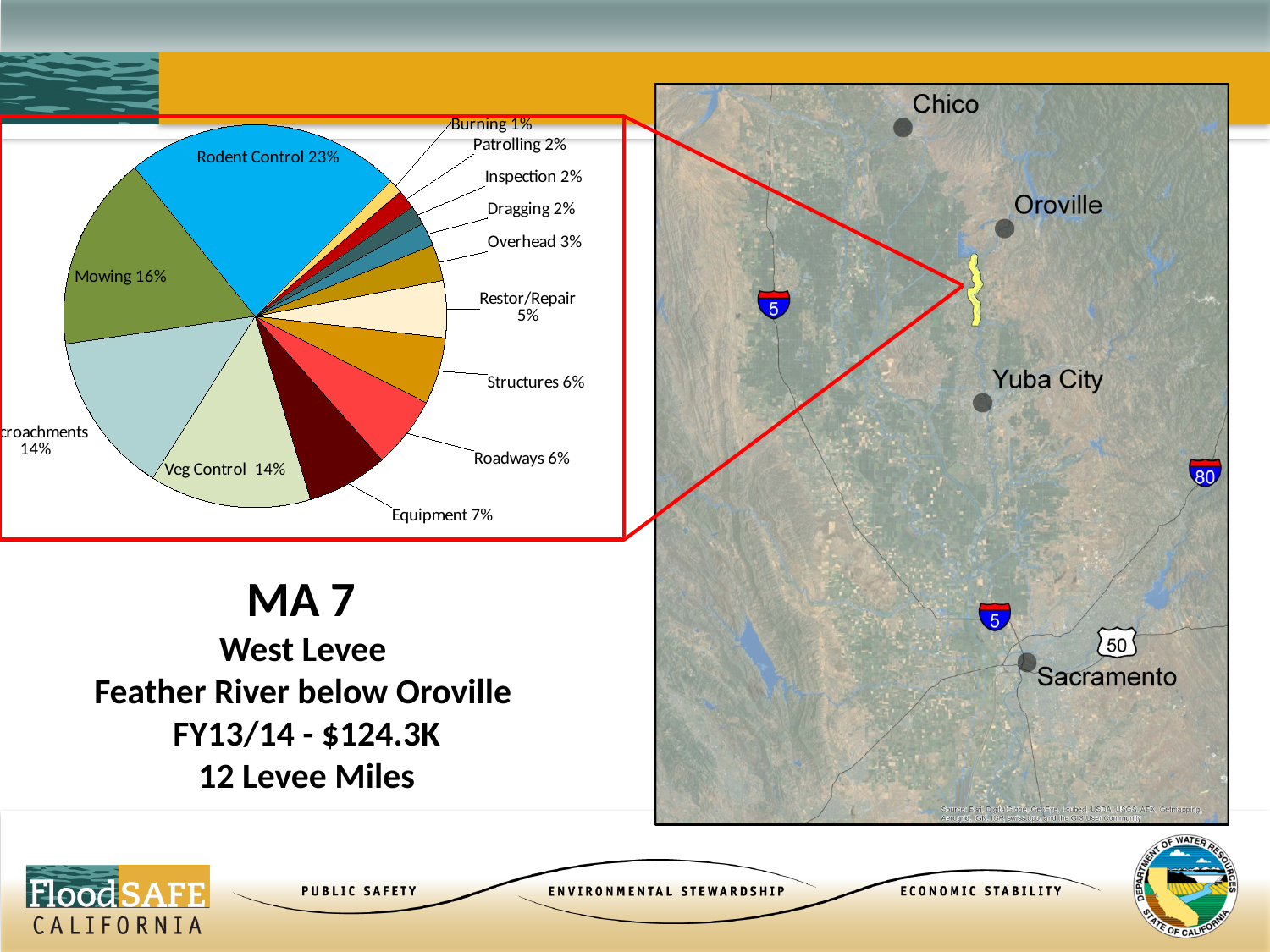
What colour is the Rodent Control slice in the pie chart? blue What percentage of the pie chart is Mowing? 16% Which category has the largest share of the pie chart? Rodent Control What percentage of the pie chart is Restor/Repair? 5% How many percentage points larger is Rodent Control than Mowing in the pie chart? 7 Which category has the smallest share of the pie chart? Burning Which has a larger share of the pie chart, Mowing or Veg Control? Mowing What percentage of the pie chart is Rodent Control? 23% What percentage of the pie chart is Overhead? 3% What percentage of the pie chart is Equipment? 7% What kind of chart is shown on the slide? pie chart How many slices does the pie chart have? 13